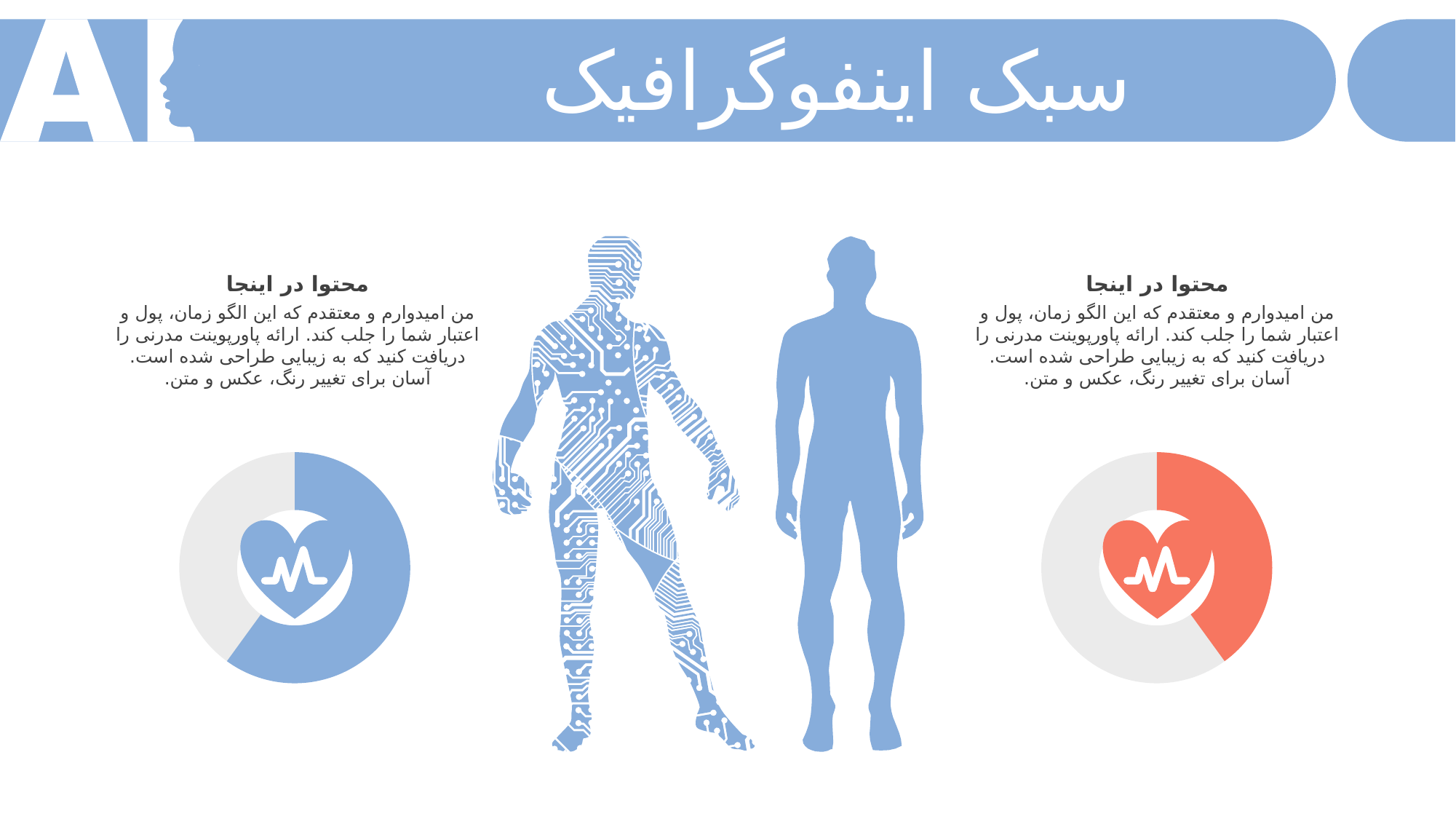
How many slices does the doughnut chart on the right side of the slide have? 2 What colour is the highlighted slice of the doughnut chart on the right side of the slide? orange In the doughnut chart on the right side of the slide, which slice is larger, the orange slice or the grey slice? the grey slice What icon is shown in the centre of each doughnut chart on the slide? a heart with a pulse line What kind of chart is the chart on the right side of the slide? doughnut chart In the doughnut chart on the left side of the slide, which slice is larger, the blue slice or the grey slice? the blue slice In the doughnut chart on the right side of the slide, does the orange slice cover more or less than half of the ring? less How many slices does the doughnut chart on the left side of the slide have? 2 What kind of chart is the chart on the left side of the slide? doughnut chart In the doughnut chart on the left side of the slide, does the blue slice cover more or less than half of the ring? more